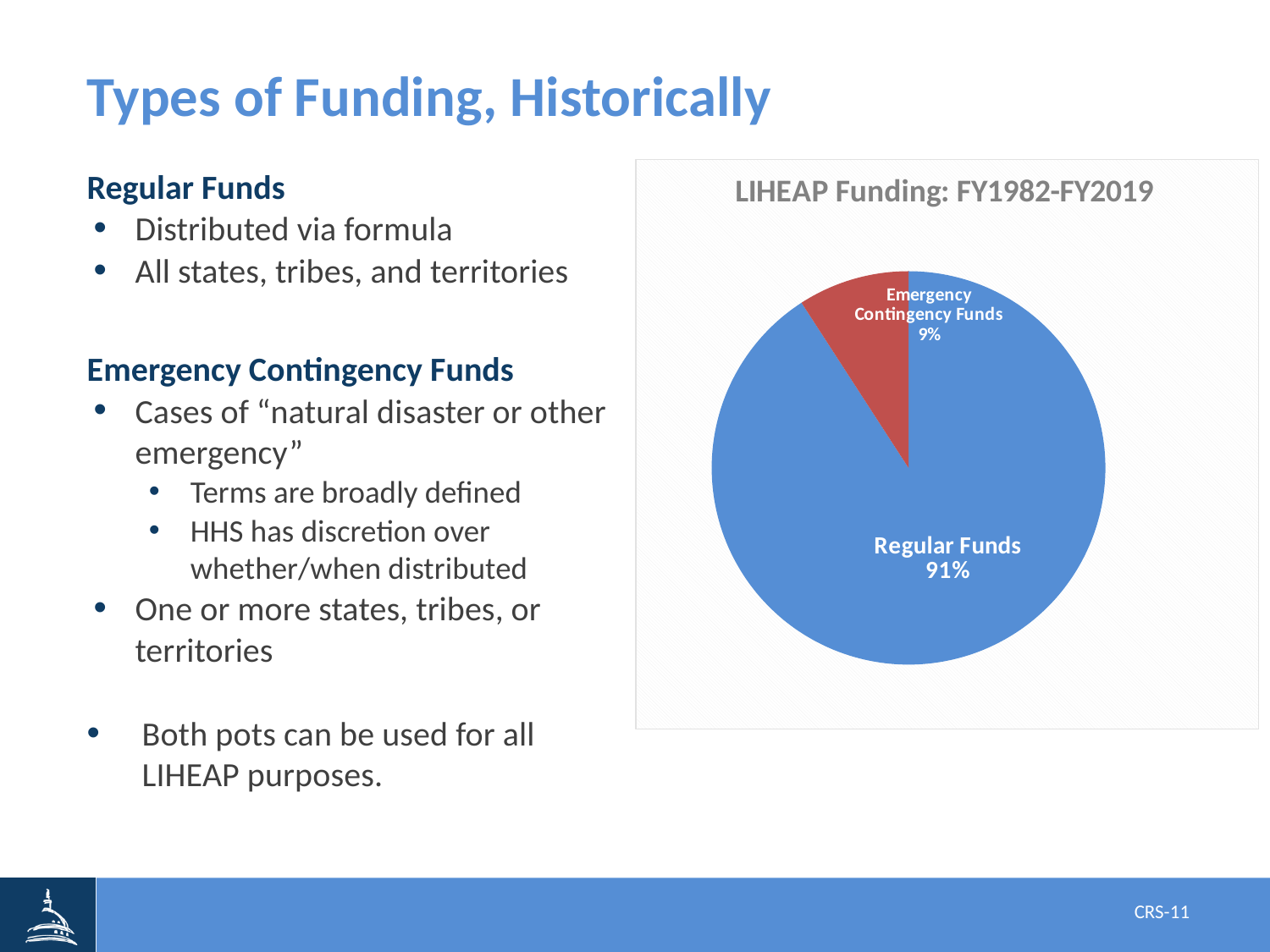
Which is larger, the share for Regular Funds or the share for Emergency Contingency Funds? Regular Funds What colour is the Emergency Contingency Funds slice? red What type of chart is shown on the slide? pie chart How many slices does the pie chart have? 2 What is the title of the chart? LIHEAP Funding: FY1982-FY2019 Which slice of the pie is the largest? Regular Funds What share of LIHEAP funding is Emergency Contingency Funds? 9% What share of LIHEAP funding is Regular Funds? 91% What is the difference in percentage points between Regular Funds and Emergency Contingency Funds? 82 Which slice of the pie is the smallest? Emergency Contingency Funds